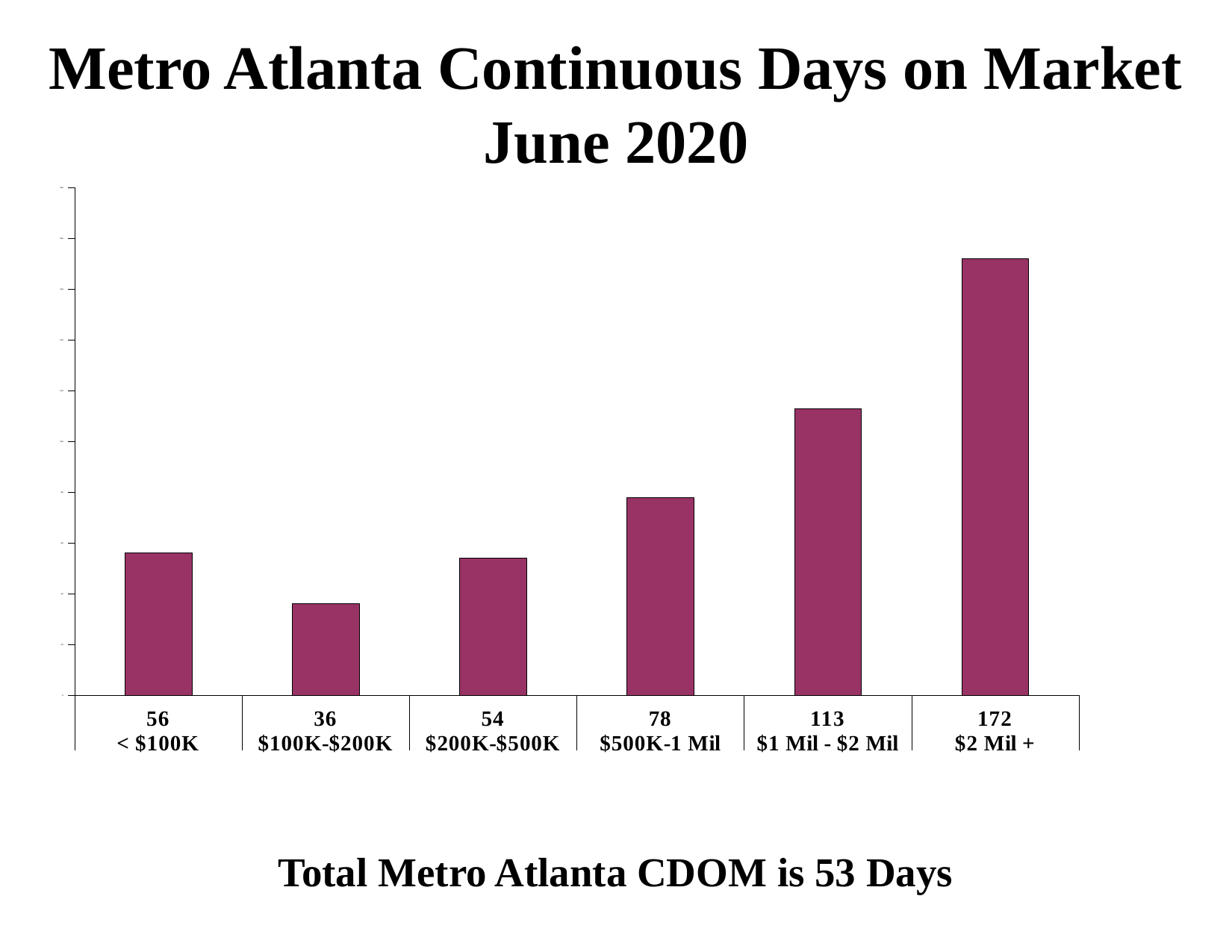
What is the continuous days on market value for the $100K-$200K price range? 36 What is the continuous days on market value for the $500K-1 Mil price range? 78 What is the difference in days on market between the < $100K and $100K-$200K price ranges? 20 What kind of chart is shown on the slide? Bar chart Which has more days on market, the < $100K range or the $200K-$500K range? < $100K According to the text below the chart, what is the total Metro Atlanta CDOM? 53 Days How many price range categories are shown in the chart? 6 From the $100K-$200K range to the $2 Mil + range, do the days on market values rise or fall? Rise Which price range has the highest continuous days on market? $2 Mil + What is the difference in days on market between the $2 Mil + and $1 Mil - $2 Mil price ranges? 59 Which price range has the lowest continuous days on market? $100K-$200K What is the continuous days on market value for the $2 Mil + price range? 172